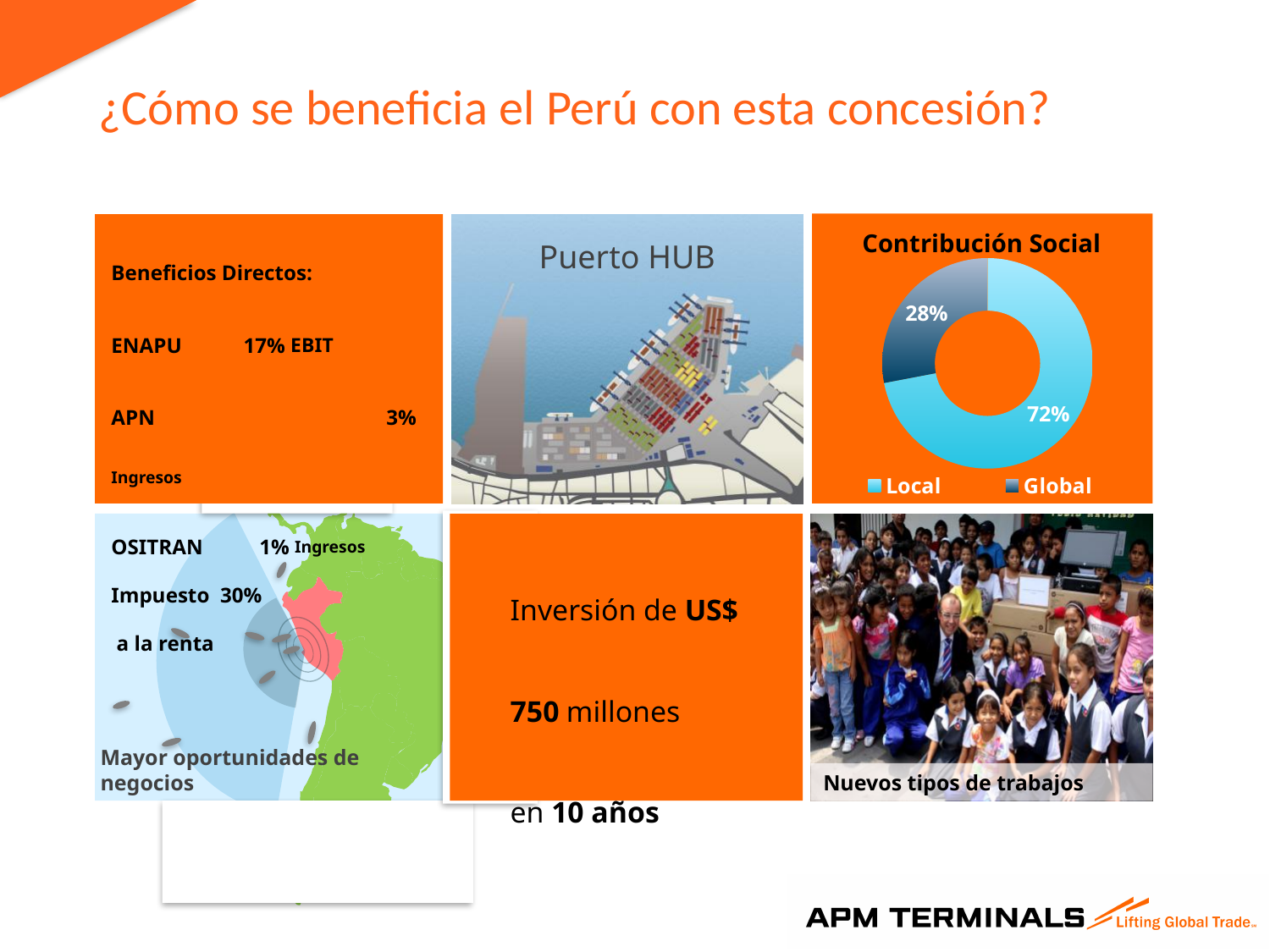
In the "Contribución Social" chart, what is the difference between the Local and Global shares? 44% In the "Contribución Social" chart, what is the value for Local? 72% What is the title of the chart on the slide? Contribución Social In the "Contribución Social" chart, which category has the smallest share? Global In the "Contribución Social" chart, which legend entry is shown in light blue? Local What kind of chart is the "Contribución Social" chart? doughnut chart How many entries does the legend of the "Contribución Social" chart list? 2 In the "Contribución Social" chart, which is larger, Local or Global? Local In the "Contribución Social" chart, what share of the whole does the Global slice represent? 28% How many categories does the "Contribución Social" chart show? 2 In the "Contribución Social" chart, which category has the largest share? Local In the "Contribución Social" chart, what is the value for Global? 28%